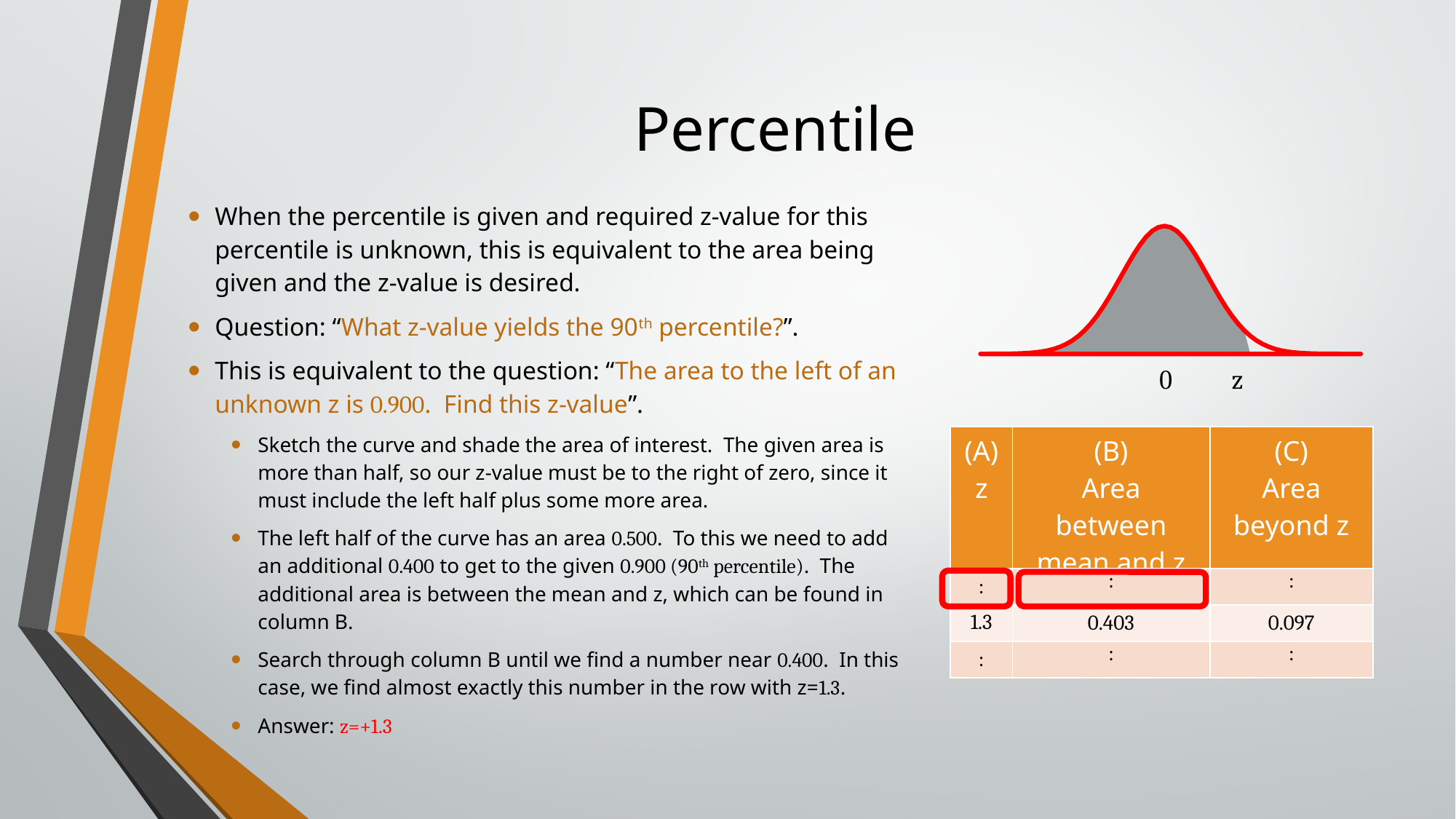
How many columns does the table have? 3 In the table, what is the area beyond z for z = 1.3? 0.097 In the table, what is the difference between the area between mean and z (0.403) and the area beyond z (0.097) for z = 1.3? 0.306 In the table, what is the area between the mean and z for z = 1.3? 0.403 What two labels appear on the horizontal axis of the bell curve? 0 and z In the table, is the area beyond z for z = 1.3 greater or less than 0.100? less In the table, which is larger for z = 1.3: the area between mean and z, or the area beyond z? Area between mean and z In the table, what is the sum of the area between mean and z and the area beyond z for z = 1.3? 0.500 Is the shaded area under the bell curve to the left or to the right of z? To the left of z What kind of chart is shown at the top right of the slide? A normal (bell) curve